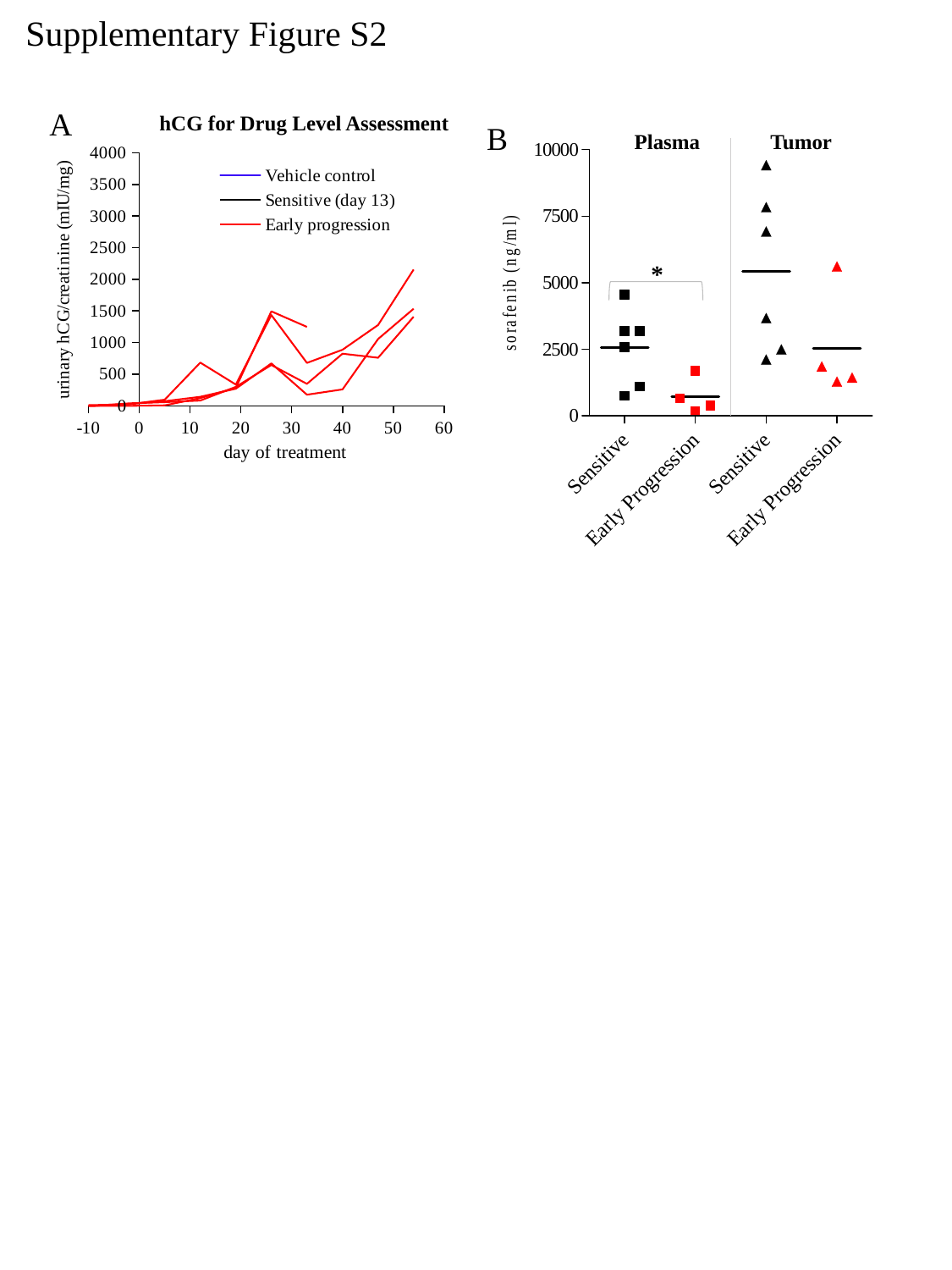
In chart A (hCG for Drug Level Assessment), is the highest value reached by any line greater or less than 2000? greater How many series does the legend of chart A (hCG for Drug Level Assessment) list? 3 In chart B, is the horizontal mean line for Sensitive in the Tumor panel greater or less than 5000? greater In chart B, which group in the Plasma panel has the higher horizontal mean line, Sensitive or Early Progression? Sensitive In chart B, is the highest Sensitive point in the Tumor panel greater or less than 7500? greater What is the y-axis label of chart B on the right of the slide? sorafenib (ng/ml) What is the title of chart A on the left of the slide? hCG for Drug Level Assessment In chart A (hCG for Drug Level Assessment), do the lines generally rise or fall as the day of treatment increases? rise What kind of chart is chart A (hCG for Drug Level Assessment)? line chart How many groups are plotted along the x axis of chart B on the right of the slide? 4